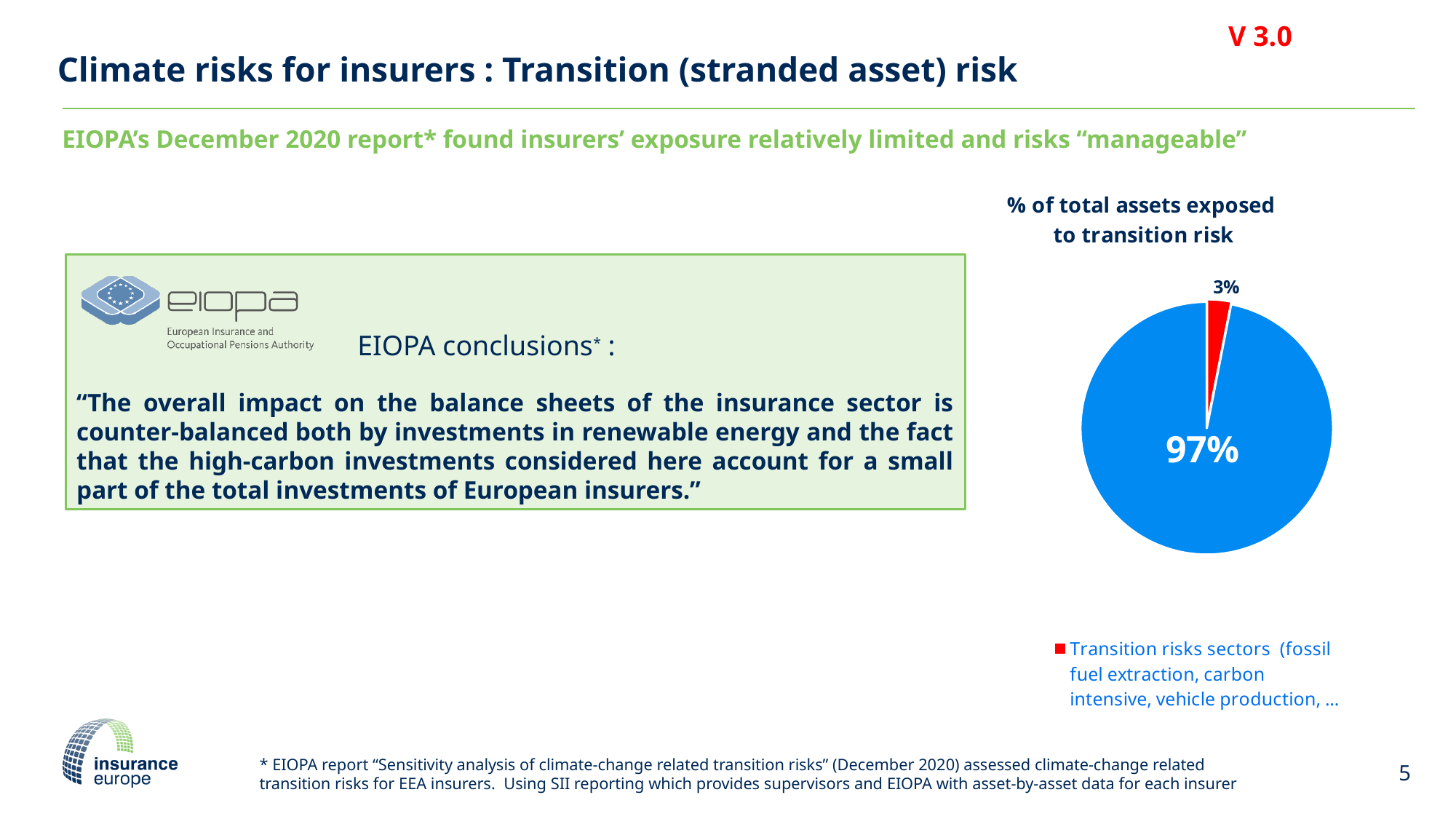
Is the share for Transition risks sectors in the pie chart greater or less than 50%? less What is the combined total of the two slices shown in the pie chart? 100% Which slice of the pie chart is the smallest? Transition risks sectors (3%) What value is printed on the large blue slice of the pie chart? 97% What is the difference in percentage points between the blue slice (97%) and the red Transition risks sectors slice (3%) in the pie chart? 94 percentage points Which slice of the pie chart is larger, the red slice or the blue slice? The blue slice What colour is the Transition risks sectors slice in the pie chart? Red What kind of chart is shown under the title "% of total assets exposed to transition risk"? Pie chart How many slices does the pie chart have? 2 What is the title of the pie chart on the slide? % of total assets exposed to transition risk What percentage of total assets is shown for the Transition risks sectors slice in the pie chart? 3%